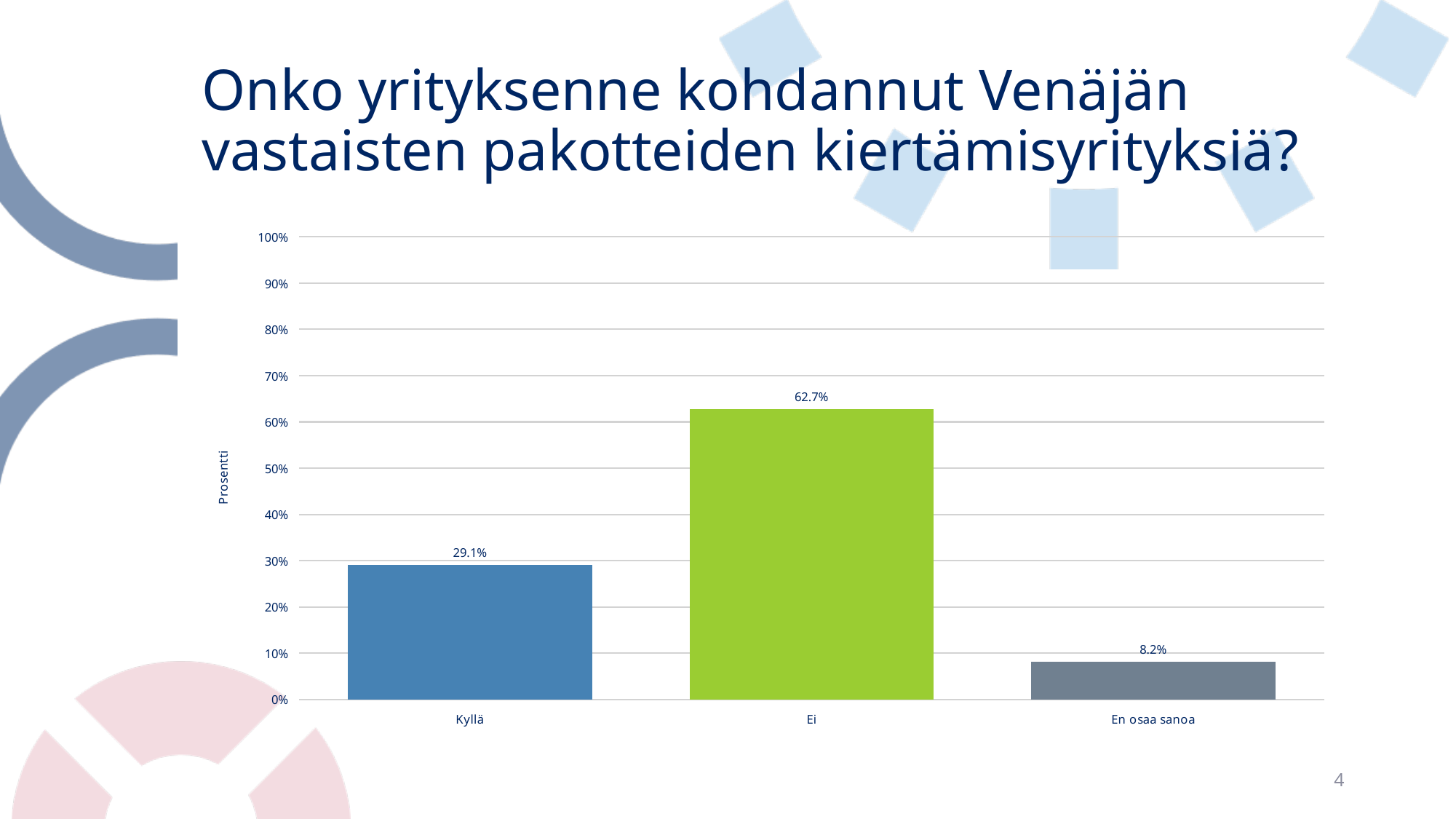
Which category has the highest value? Ei How many categories are shown on the x axis? 3 Which category has the lowest value? En osaa sanoa What is the difference between the values for Kyllä and En osaa sanoa? 20.9% What is the value for Ei? 62.7% What is the label of the vertical axis? Prosentti What is the value for Kyllä? 29.1% What is the difference between the values for Ei and Kyllä? 33.6% Which is larger, the value for Kyllä or the value for En osaa sanoa? Kyllä Is the value for Ei greater or less than 50%? greater What kind of chart is shown on the slide? bar chart What is the value for En osaa sanoa? 8.2%